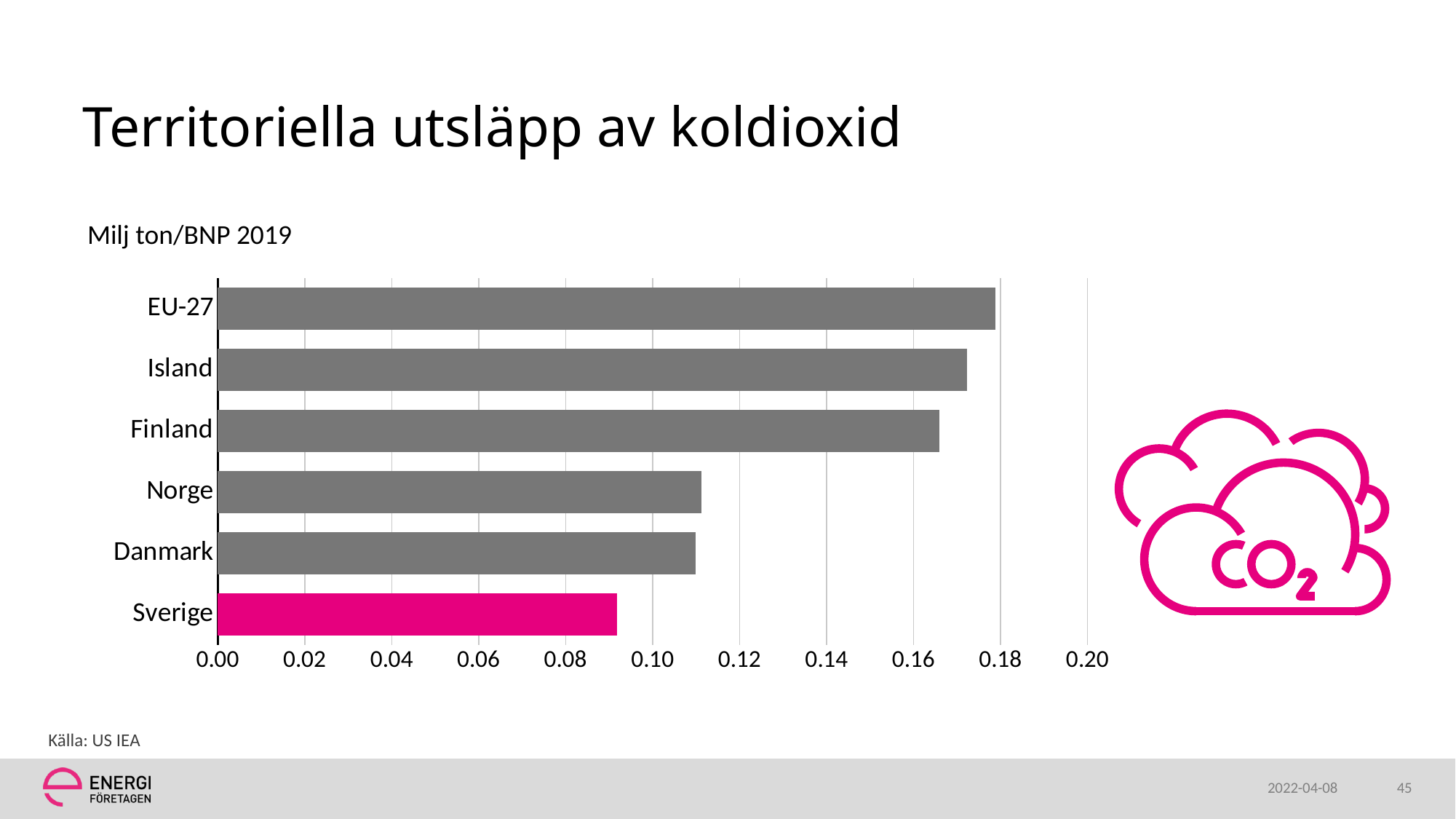
Is the value for Sverige greater or less than 0.08? greater Is the value for Finland greater or less than 0.16? greater What kind of chart is shown on the slide? bar chart Which category has the highest value in the chart? EU-27 Which has a larger value, Finland or Norge? Finland Which bar in the chart is coloured pink rather than grey? Sverige Is the value for Norge greater or less than 0.10? greater Which category has the lowest value in the chart? Sverige How many countries or regions are shown in the chart? 6 Which has a larger value, Sverige or Danmark? Danmark